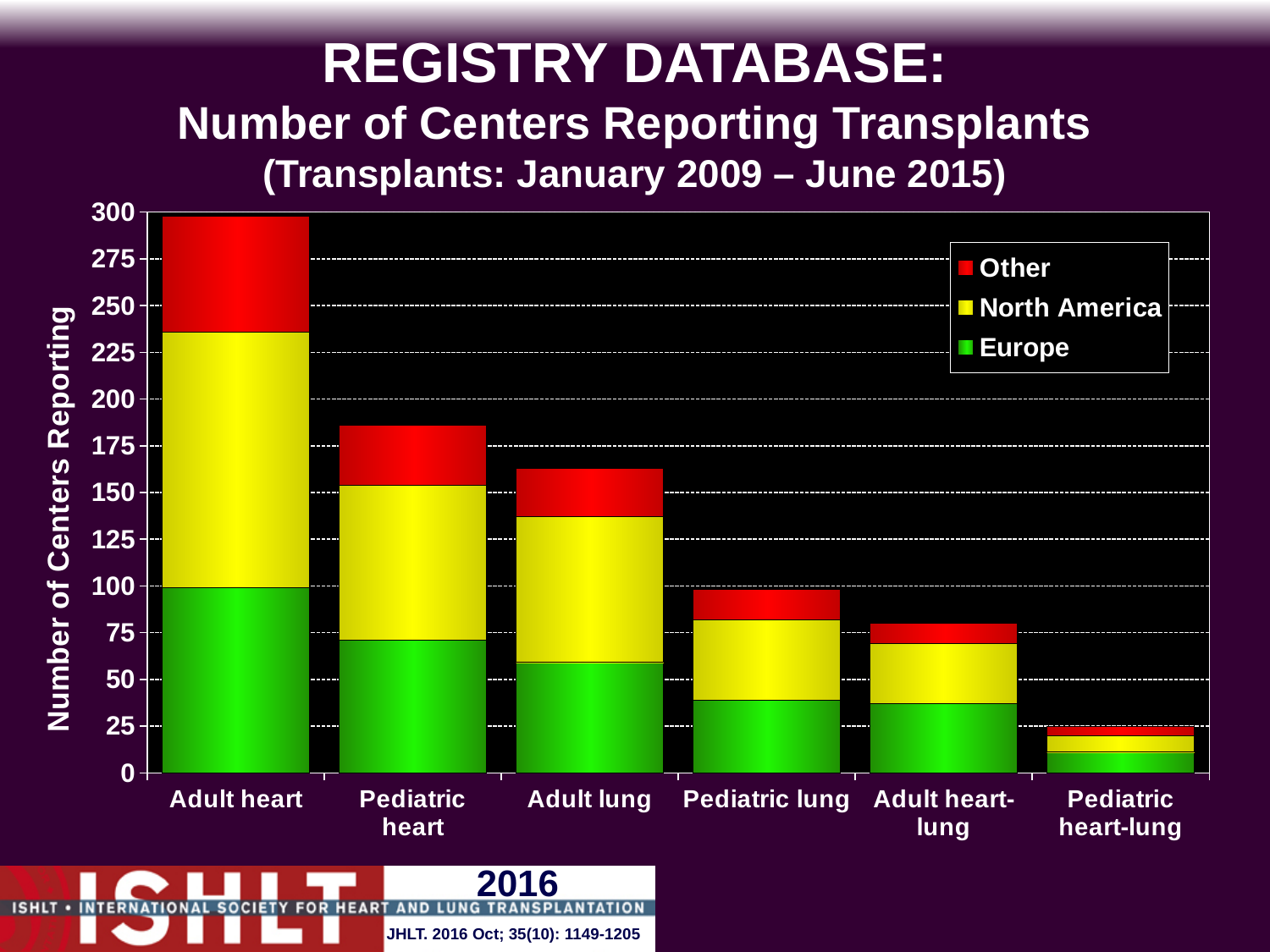
Is the total number of centers reporting for Adult heart greater or less than 275? greater How many series does the legend list? 3 Which category has the highest total number of centers reporting? Adult heart Is the total number of centers reporting for Adult lung greater or less than 175? less Do the total bar heights rise or fall moving from left to right along the x axis? fall What kind of chart is shown on the slide? Stacked bar chart How many transplant categories are shown along the x axis? 6 Which category has the lowest total number of centers reporting? Pediatric heart-lung Is the total number of centers reporting for Adult heart-lung greater or less than 100? less Which colour represents Europe in the legend? Green Which has a larger total number of centers reporting, Pediatric heart or Adult lung? Pediatric heart